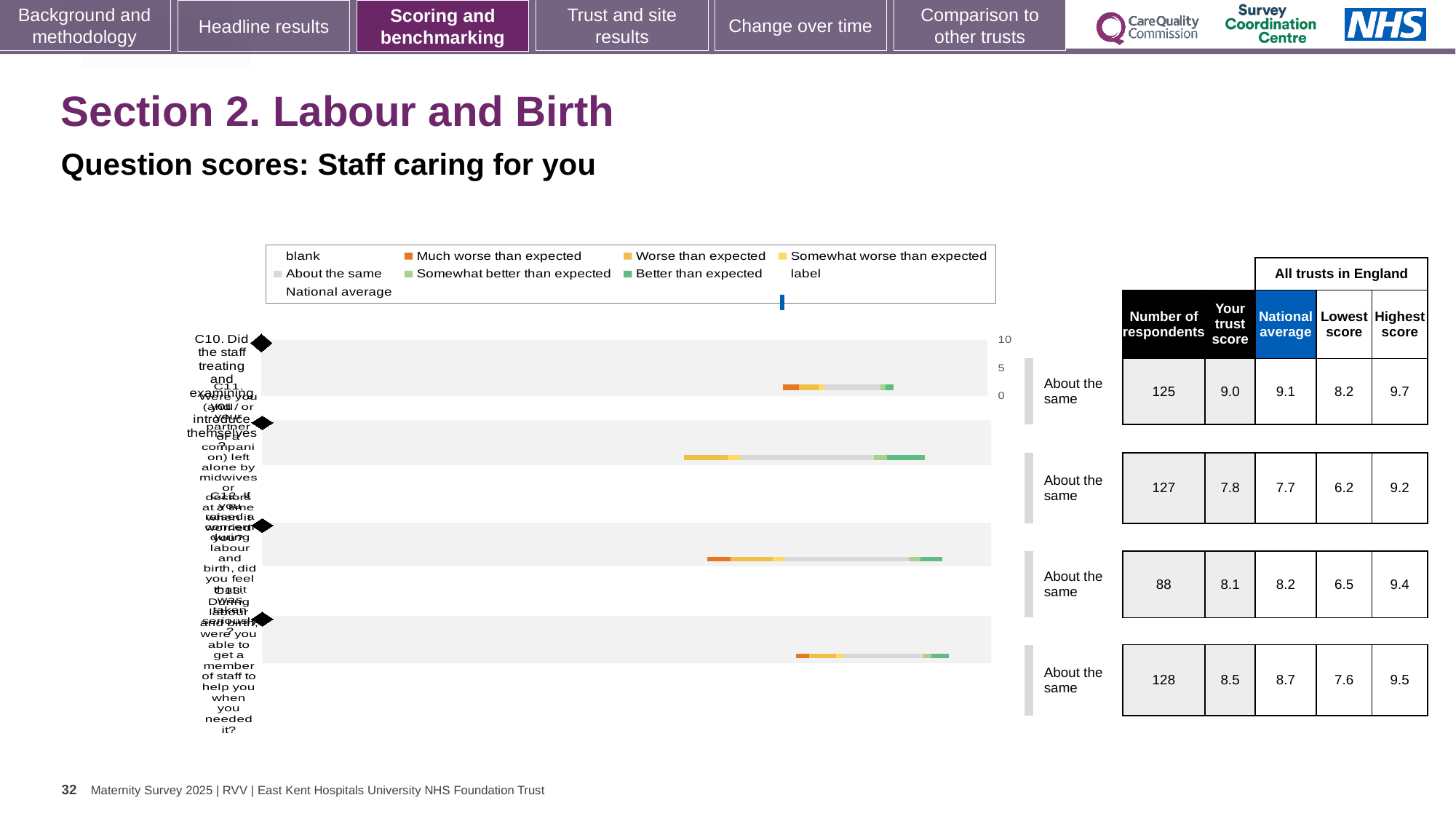
What colour represents 'Much worse than expected' in the legend? orange Which question row has the lowest number of respondents? the third row, 88 What is the difference between the highest score and the lowest score for the second question row? 3.0 What is the trust score for the second question row (C11)? 7.8 What kind of chart is shown on the slide? bar chart What is the national average for the fourth (bottom) question row? 8.7 How many question rows are plotted in the chart? 4 What is the number of respondents for the first question row (C10)? 125 Which question row has the highest number of respondents? the fourth (bottom) row, 128 For the third question row, is the trust score or the national average larger? national average (8.2) What benchmark category is shown for the first question row (C10)? About the same What is the lowest score among all trusts in England for the first question row (C10)? 8.2